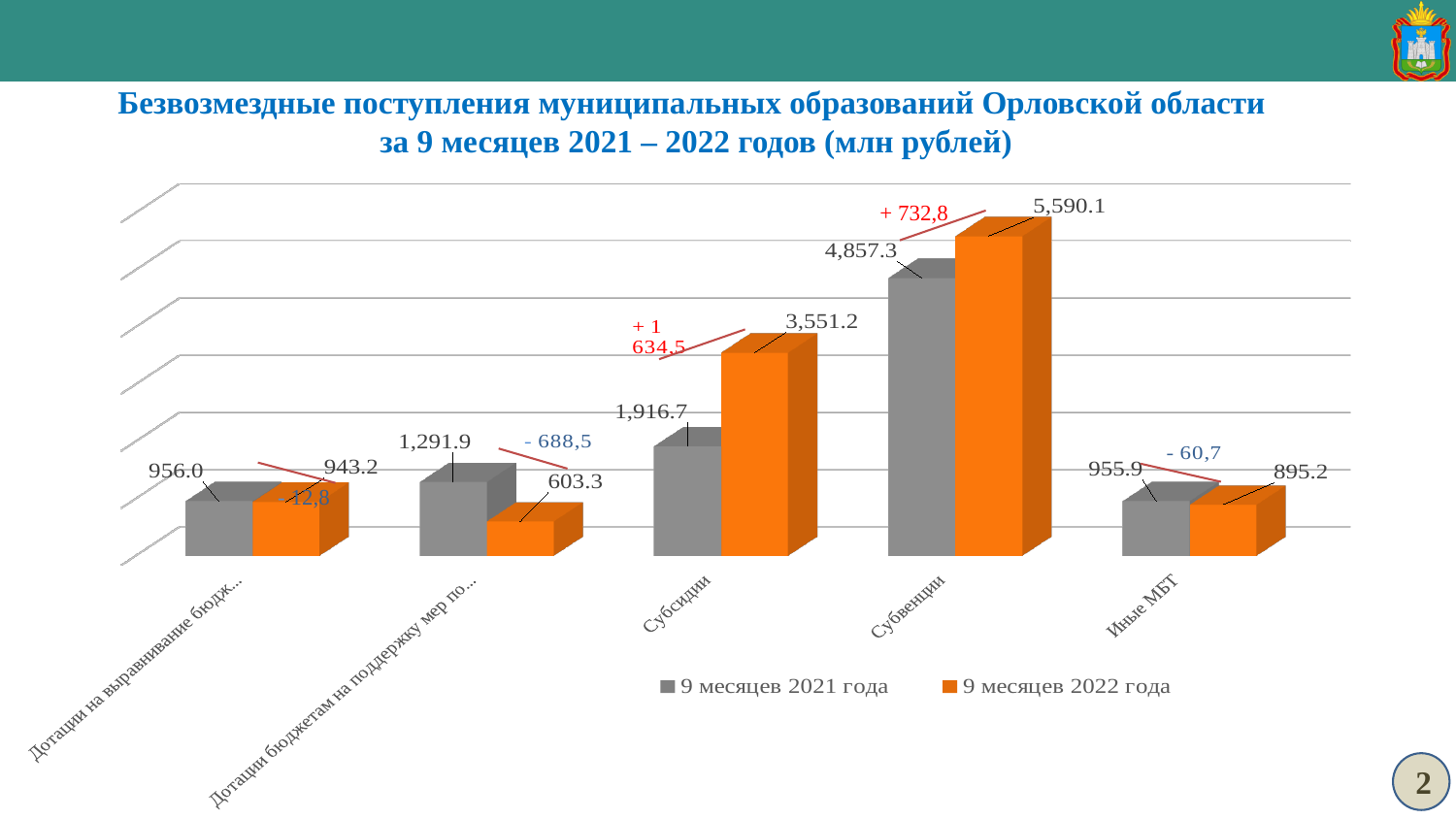
Which category has the lowest value in the series 9 месяцев 2022 года? Дотации бюджетам на поддержку мер по... What is the difference between the 9 месяцев 2022 года and 9 месяцев 2021 года values for Субвенции? 732.8 What is the value for Субсидии in the series 9 месяцев 2021 года? 1,916.7 For Иные МБТ, which is larger: the 9 месяцев 2021 года value or the 9 месяцев 2022 года value? 9 месяцев 2021 года What kind of chart is shown on the slide? Bar chart Which category has the highest value in the series 9 месяцев 2022 года? Субвенции What is the value for Субвенции in the series 9 месяцев 2022 года? 5,590.1 What is the difference between the 9 месяцев 2022 года and 9 месяцев 2021 года values for Субсидии? 1,634.5 How many categories are shown on the x axis of the chart? 5 What is the value for Субвенции in the series 9 месяцев 2021 года? 4,857.3 How many series does the legend list? 2 What is the value for Иные МБТ in the series 9 месяцев 2022 года? 895.2